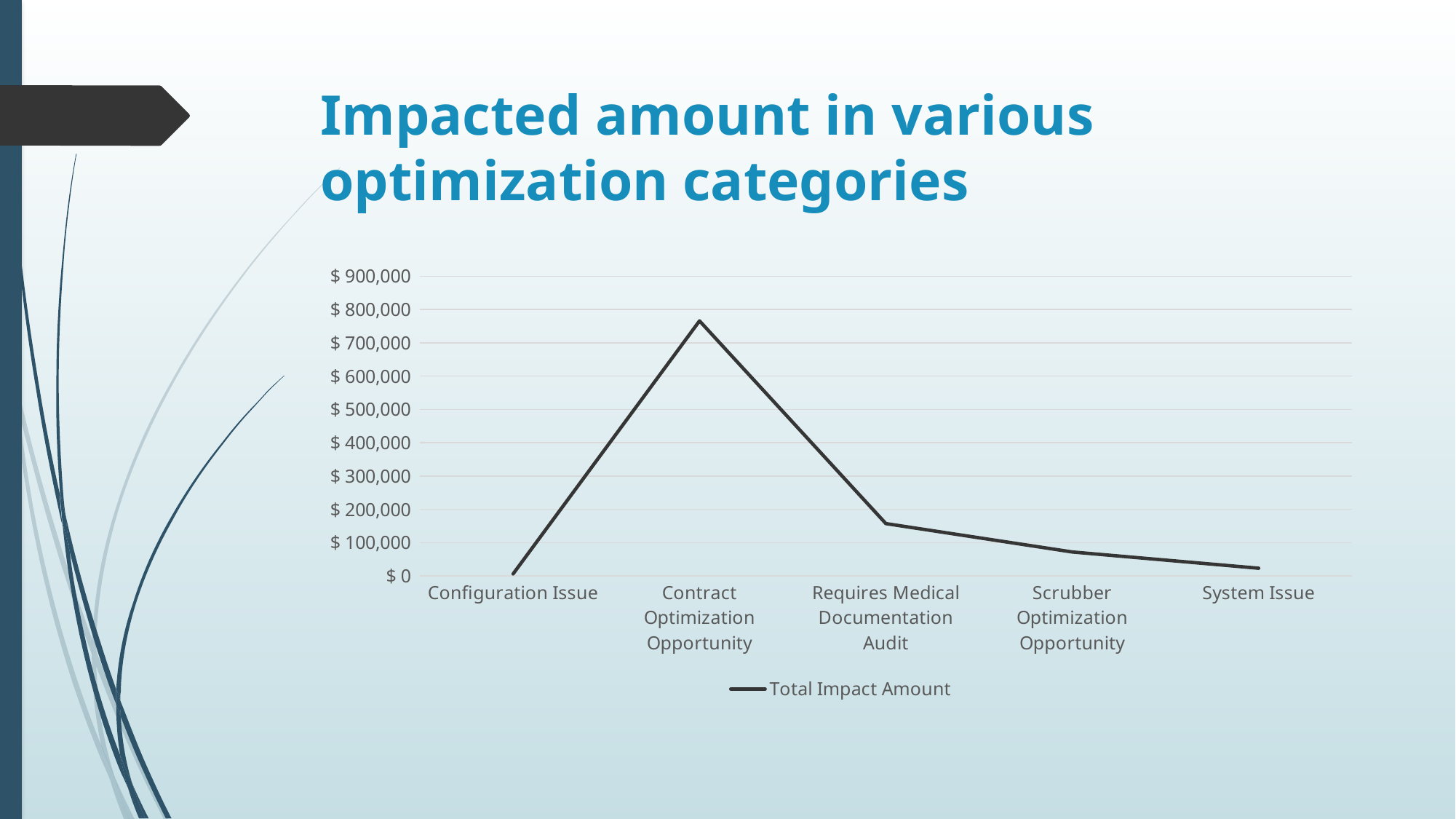
Is the Total Impact Amount for Scrubber Optimization Opportunity greater or less than $ 100,000? less Is the Total Impact Amount for Contract Optimization Opportunity greater or less than $ 700,000? greater What kind of chart is shown on the slide? line chart What is the name of the series shown in the legend? Total Impact Amount How many categories are plotted along the x axis? 5 How many series does the legend list? 1 Which category has the highest Total Impact Amount? Contract Optimization Opportunity Is the Total Impact Amount for Configuration Issue greater or less than $ 100,000? less Which has a larger Total Impact Amount, Contract Optimization Opportunity or System Issue? Contract Optimization Opportunity Which has a larger Total Impact Amount, Requires Medical Documentation Audit or Scrubber Optimization Opportunity? Requires Medical Documentation Audit Do the values rise or fall from Contract Optimization Opportunity to System Issue? fall